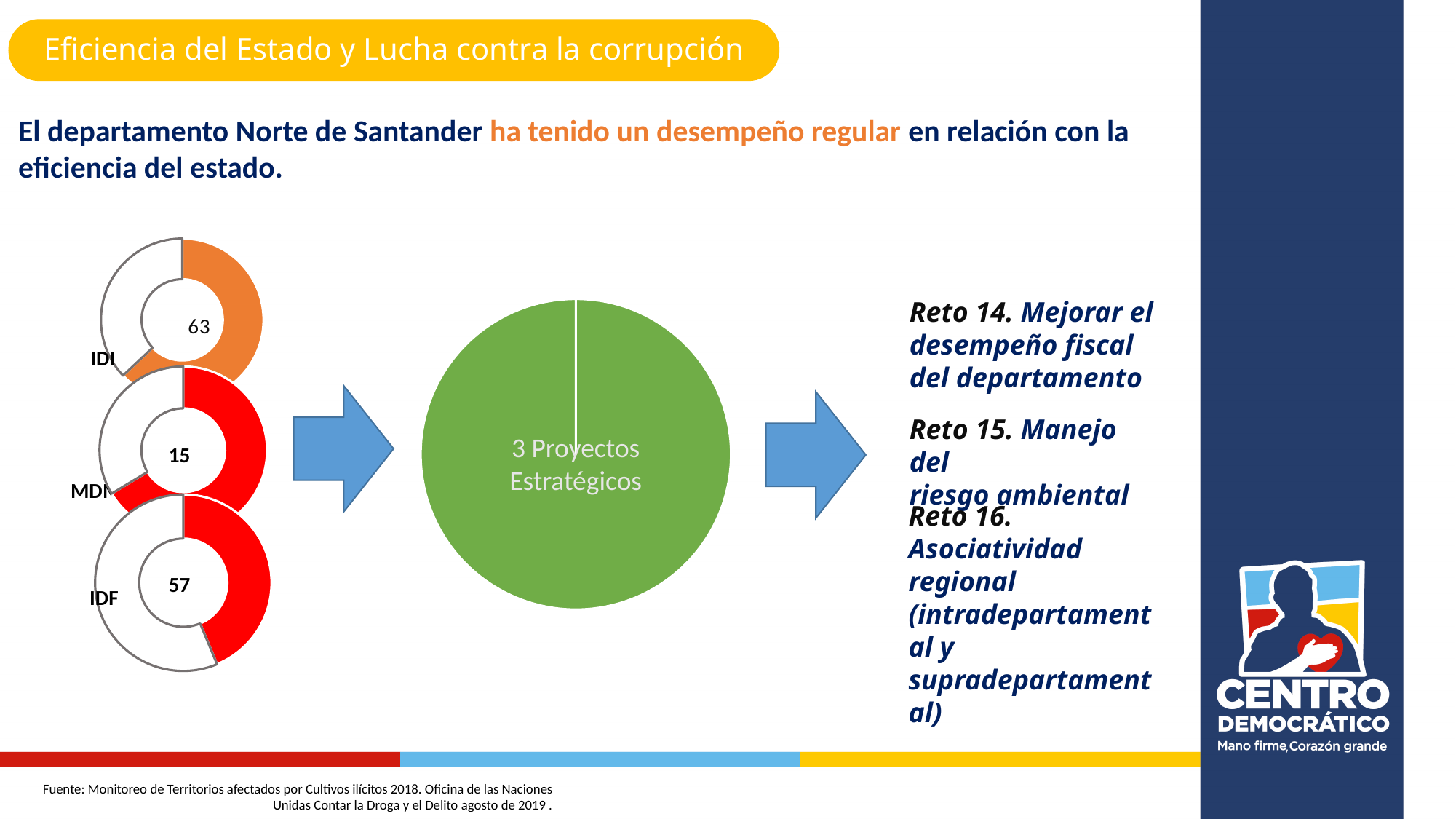
What value is shown in the centre of the IDF doughnut chart? 57 What value is shown in the centre of the IDI doughnut chart? 63 What is the difference between the IDF value and the MDI value? 42 Which is larger, the IDI value or the IDF value? IDI What kind of chart is used to show the IDI, MDI and IDF values? Doughnut chart What colour is the filled portion of the IDI doughnut chart? Orange What is the difference between the IDI value and the IDF value? 6 Among the three doughnut charts (IDI, MDI, IDF), which has the highest value? IDI What value is shown in the centre of the MDI doughnut chart? 15 Among the three doughnut charts (IDI, MDI, IDF), which has the lowest value? MDI What colour is the filled portion of the MDI doughnut chart? Red How many doughnut charts are shown on the left side of the slide? 3